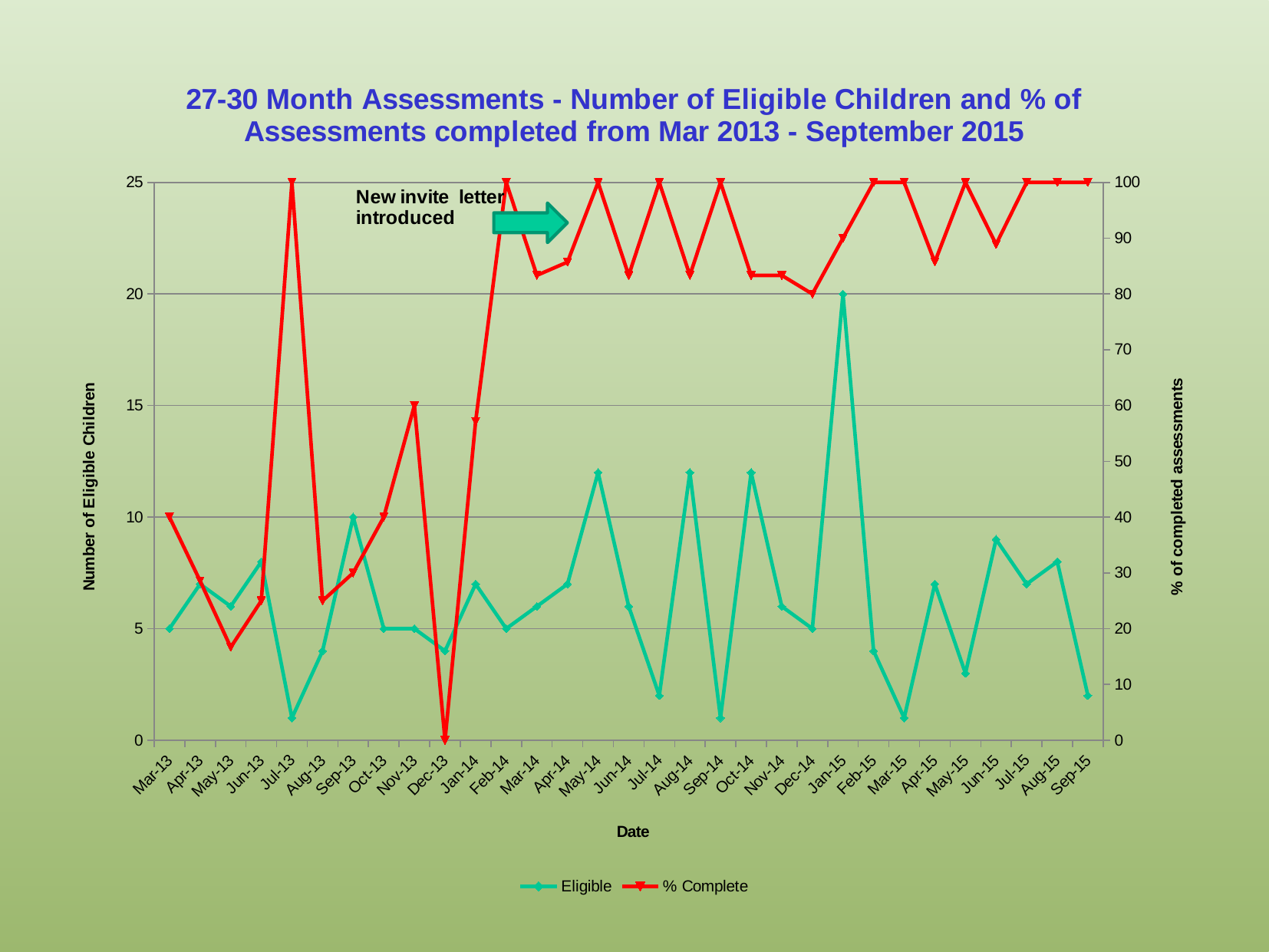
Is the number of eligible children in Sep-15 greater or less than 5? less How many months are plotted along the x axis? 31 What is the % Complete value for Dec-13? 0 What is the number of eligible children in Jan-15? 20 What are the two series named in the legend? Eligible and % Complete What is the % Complete value for Mar-13? 40 What does the annotation with the arrow on the chart say? New invite letter introduced How many series does the legend list? 2 In which month is the % Complete value lowest? Dec-13 In which month is the number of eligible children highest? Jan-15 What kind of chart is shown on the slide? line chart What is the difference between the number of eligible children in Jan-15 and in Mar-13? 15